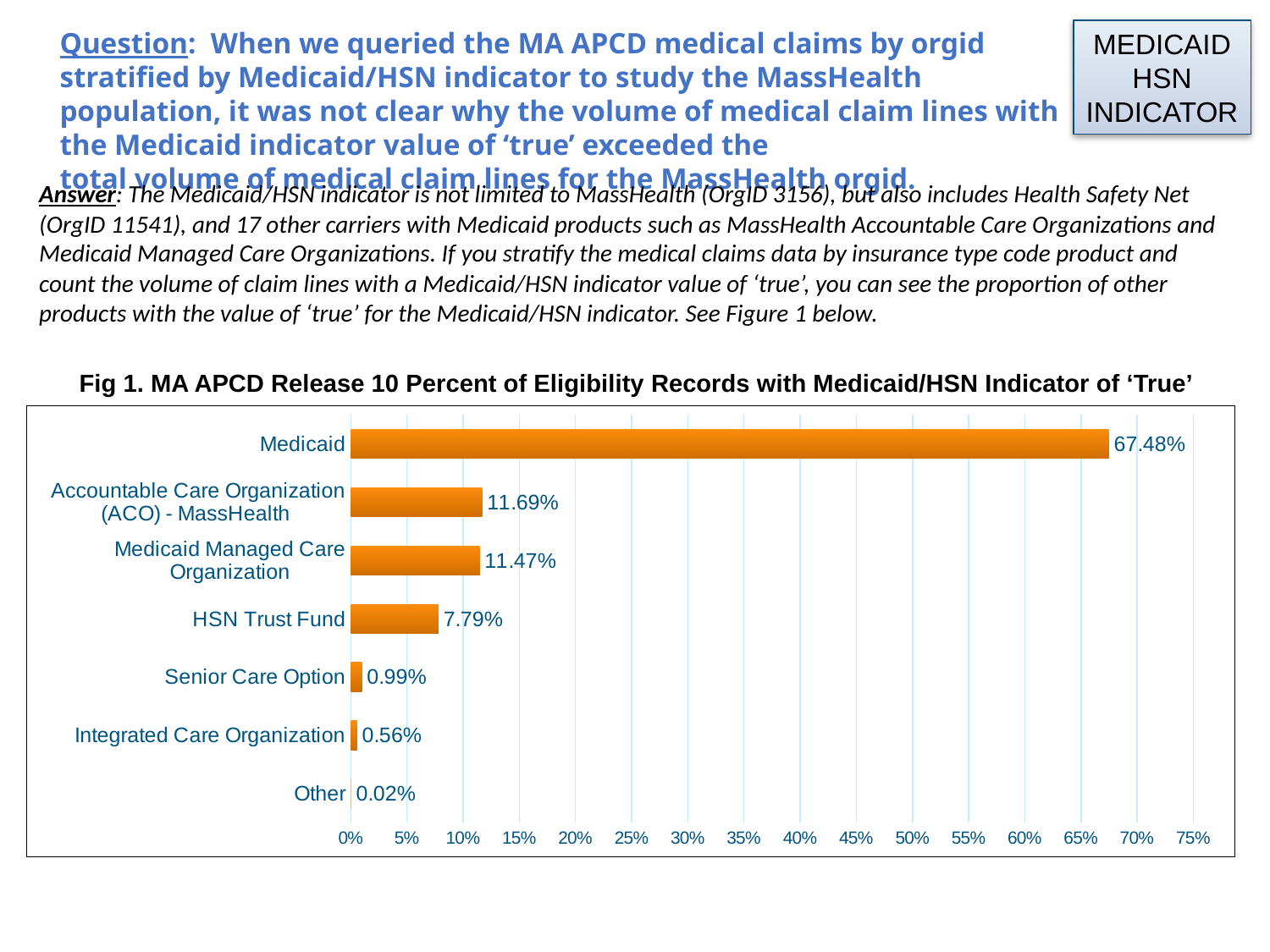
What is the title of the chart? Fig 1. MA APCD Release 10 Percent of Eligibility Records with Medicaid/HSN Indicator of 'True' Which is larger, the value for Accountable Care Organization (ACO) - MassHealth or the value for Medicaid Managed Care Organization? Accountable Care Organization (ACO) - MassHealth What is the difference between the values for Medicaid and HSN Trust Fund? 59.69% What is the value for Medicaid? 67.48% Which category has the highest value? Medicaid What is the value for HSN Trust Fund? 7.79% Is the value for Medicaid greater or less than 65%? greater What kind of chart is shown on the slide? bar chart Which category has the lowest value? Other What is the value for Integrated Care Organization? 0.56% How many categories are shown in the chart? 7 What is the value for Senior Care Option? 0.99%